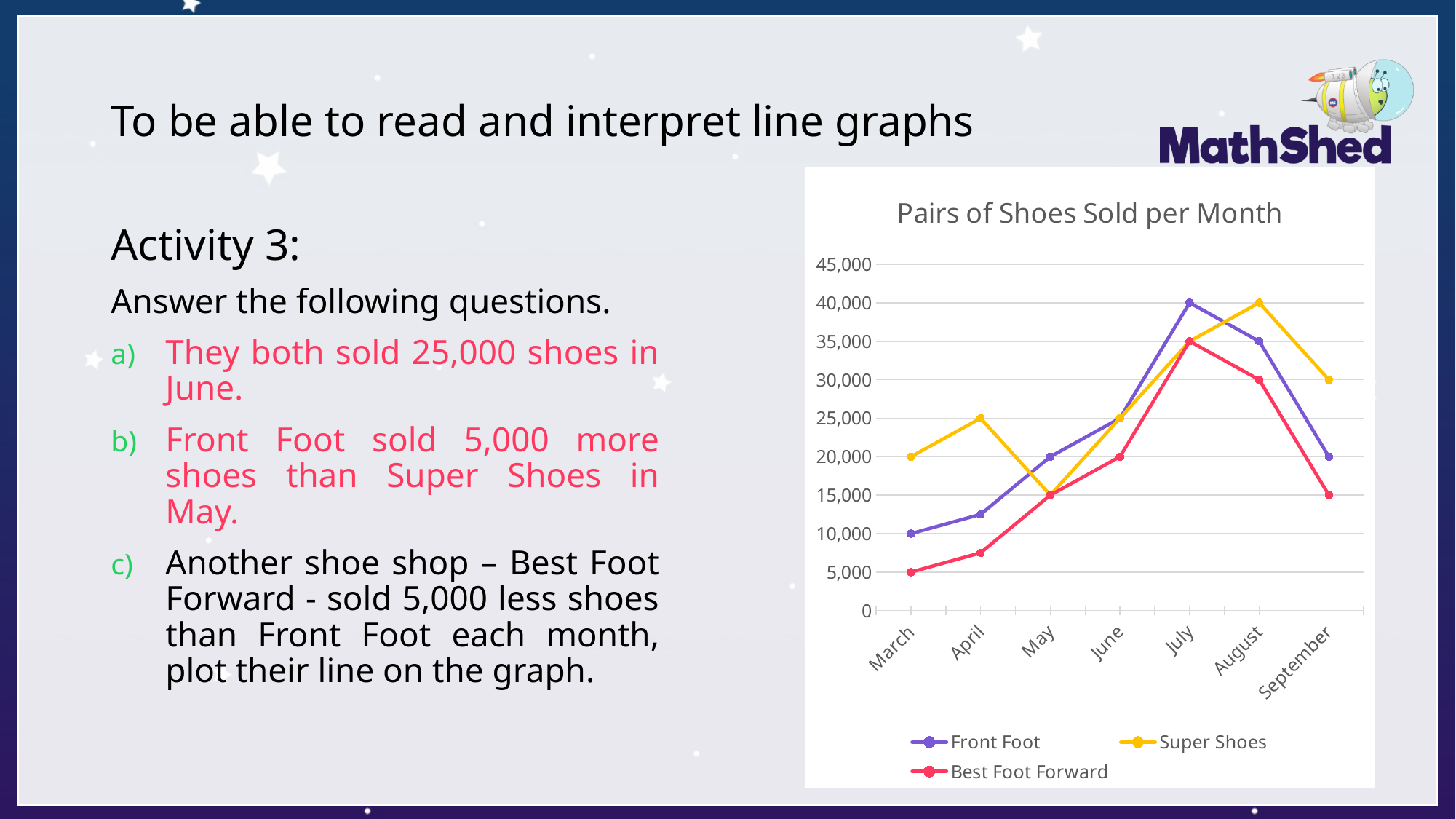
In which month did Super Shoes sell the fewest pairs of shoes? May How many pairs of shoes did Front Foot sell in July? 40,000 What kind of chart is shown on the slide? line chart Is the value for Front Foot in April greater or less than 15,000? less How many series does the legend list? 3 What is the title of the chart? Pairs of Shoes Sold per Month Which sold more pairs of shoes in September, Super Shoes or Front Foot? Super Shoes What is the difference between Front Foot's and Super Shoes' sales in May? 5,000 How many months are plotted along the x axis? 7 How many pairs of shoes did Super Shoes sell in August? 40,000 In which month did Front Foot sell the most pairs of shoes? July How many pairs of shoes did Best Foot Forward sell in March? 5,000